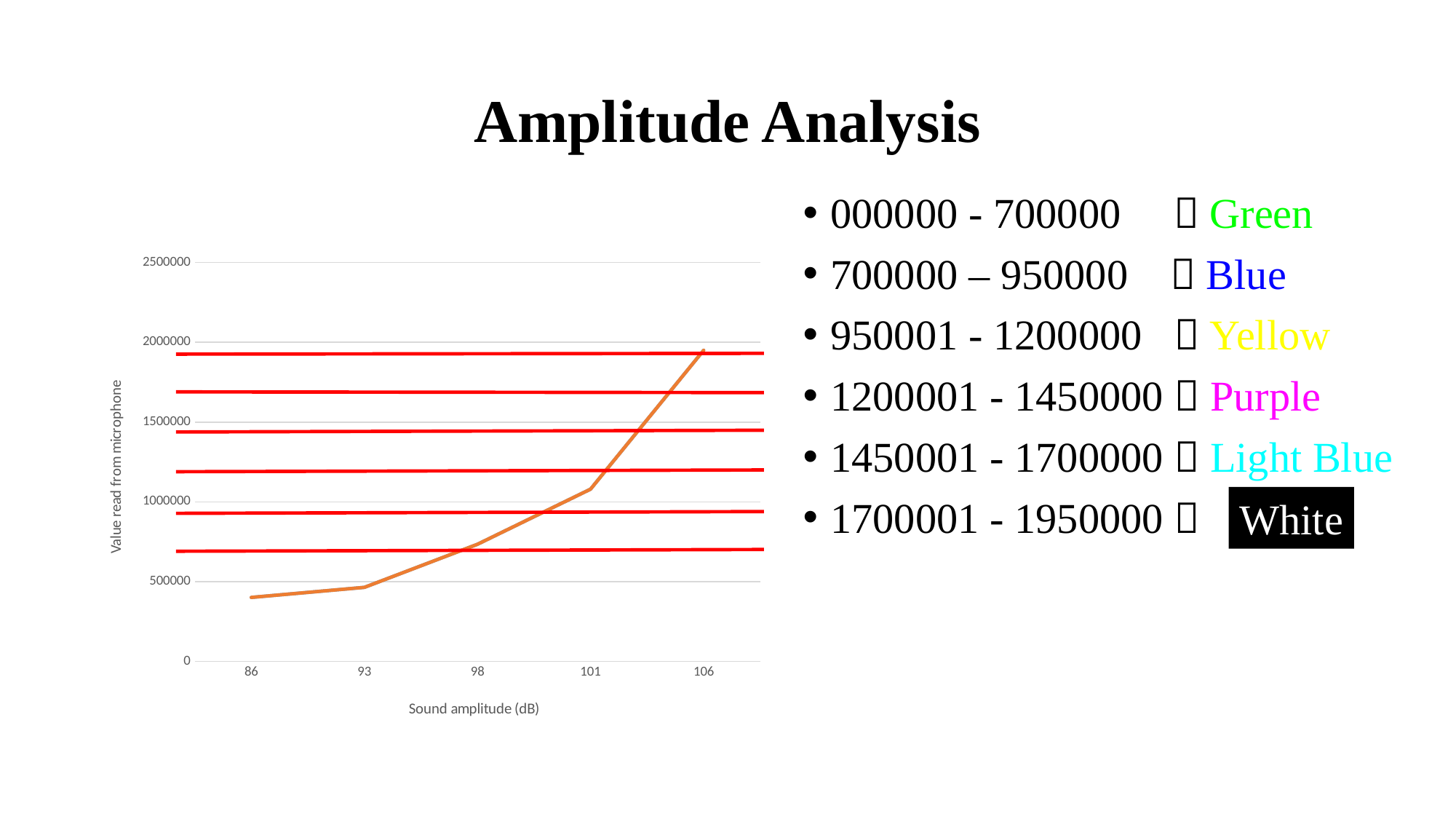
Is the value read from the microphone at 98 dB greater or less than 1000000? less Is the value read from the microphone at 106 dB greater or less than 1500000? greater Does the orange line rise or fall as sound amplitude increases along the x axis? rises Which has the larger value read from the microphone, 101 dB or 106 dB? 106 dB What is the title of the y axis of the chart? Value read from microphone Is the value read from the microphone at 98 dB greater or less than 500000? greater At which sound amplitude (dB) does the orange line reach its highest value? 106 At which sound amplitude (dB) does the orange line have its lowest value? 86 How many sound amplitude values are labelled on the x axis of the chart? 5 What kind of chart is shown on the slide? line chart What is the title of the x axis of the chart? Sound amplitude (dB)